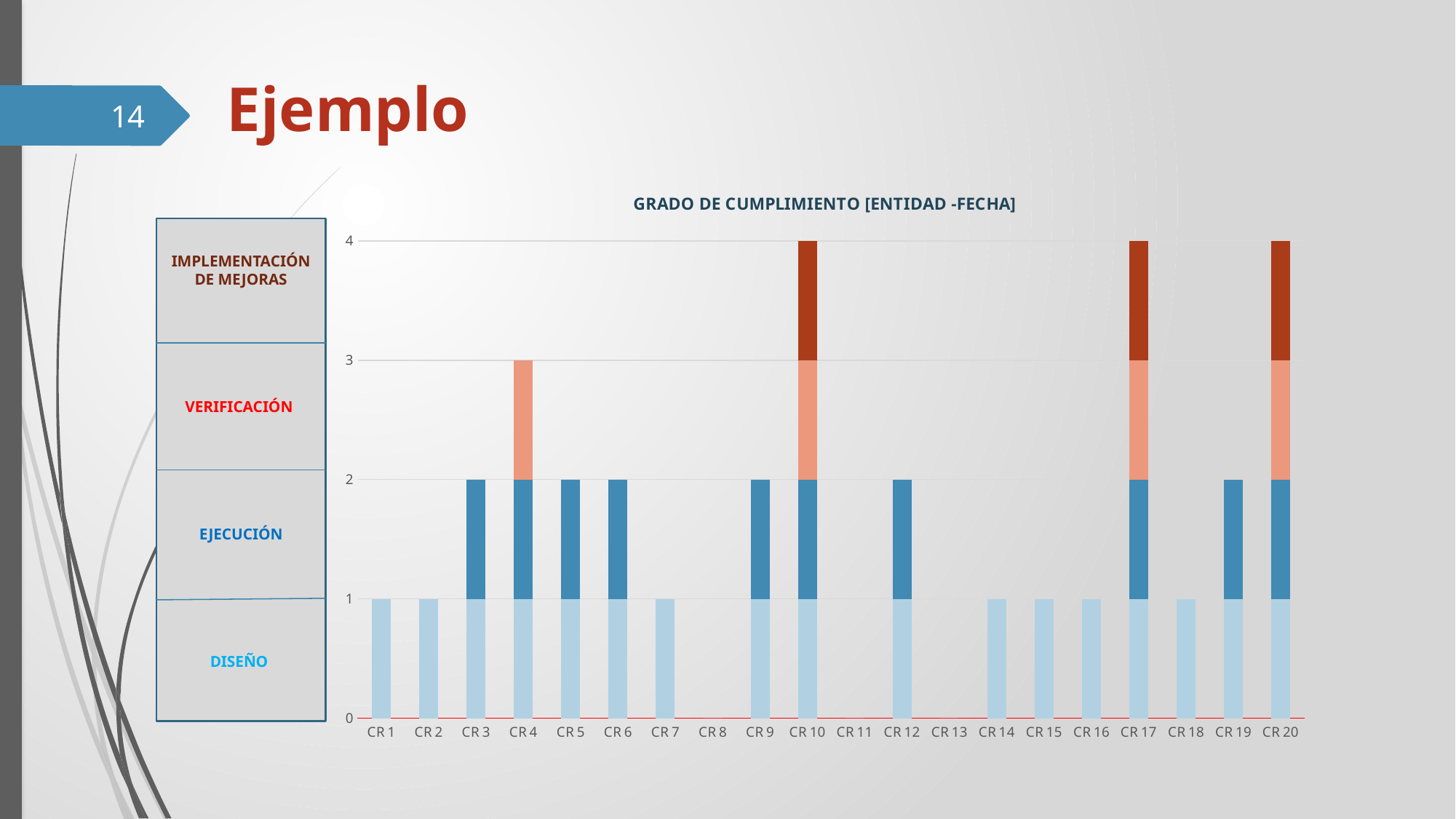
How many categories (CR bars) are shown along the x axis? 20 What kind of chart is shown on the slide? Stacked bar chart Is the total value for CR 17 greater or less than 3? greater What is the difference between the total for CR 10 and the total for CR 3? 2 What is the total height of the stacked bar for CR 10? 4 How many stages are listed in the table to the left of the chart? 4 What is the value shown for CR 8? 0 Which categories reach the highest total value on the chart? CR 10, CR 17 and CR 20 Which has a taller stacked bar, CR 4 or CR 5? CR 4 Which categories have the lowest total value (no bar at all)? CR 8, CR 11 and CR 13 What is the total height of the stacked bar for CR 4? 3 What is the title of the chart? GRADO DE CUMPLIMIENTO [ENTIDAD -FECHA]